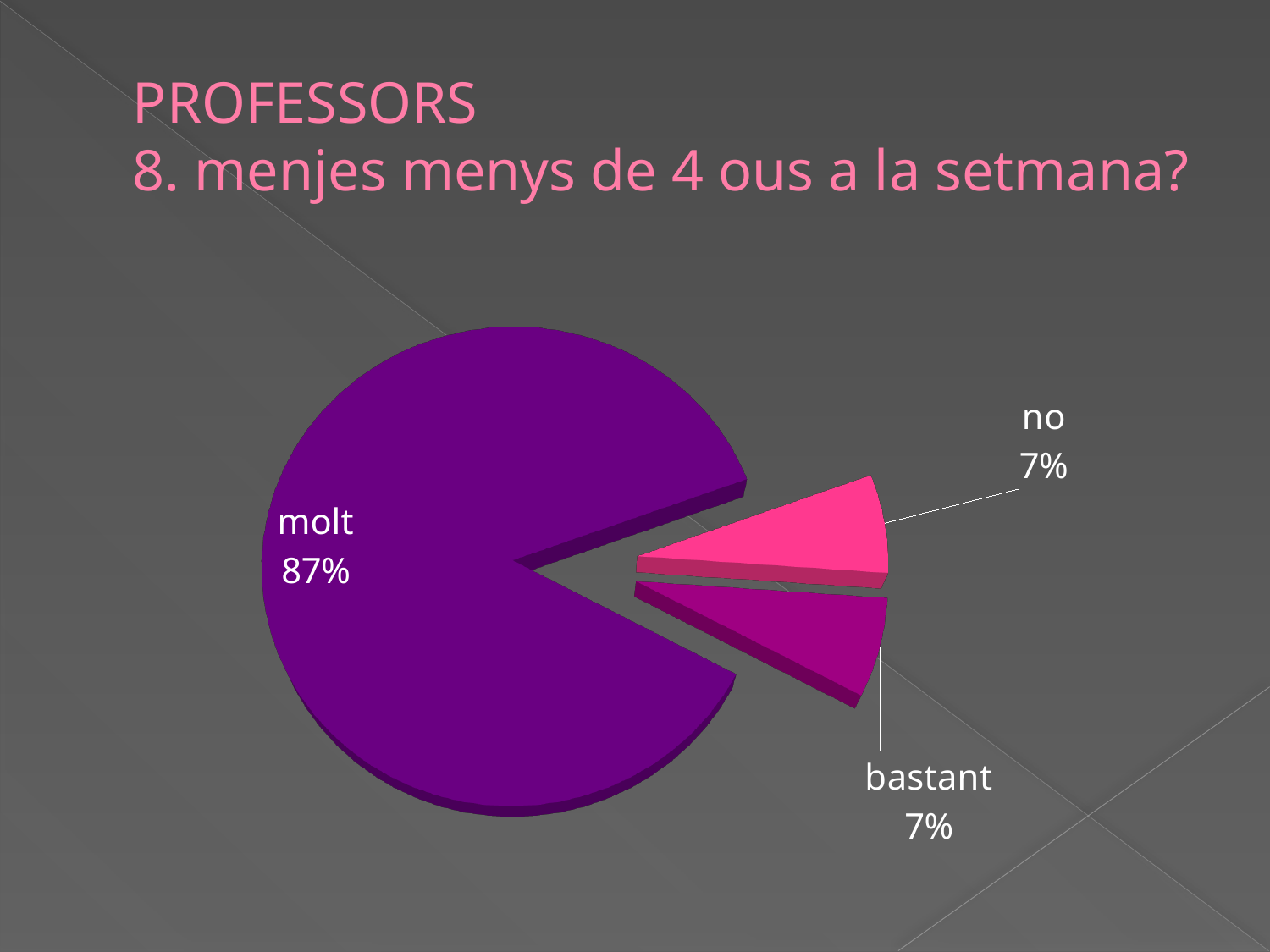
Which category has the largest slice of the pie? molt What is the difference in percentage points between the "molt" slice and the "no" slice? 80 What is the combined share of the "no" and "bastant" slices? 14% What share of the pie does the "no" slice represent? 7% What kind of chart is shown on the slide? pie chart What question is shown as the title above the chart? 8. menjes menys de 4 ous a la setmana? Which is larger, the "molt" slice or the "bastant" slice? molt Is the share for "molt" greater or less than 50%? greater How many slices does the pie chart have? 3 What share of the pie does the "bastant" slice represent? 7% What share of the pie does the "molt" slice represent? 87% What colour is the "molt" slice of the pie? purple